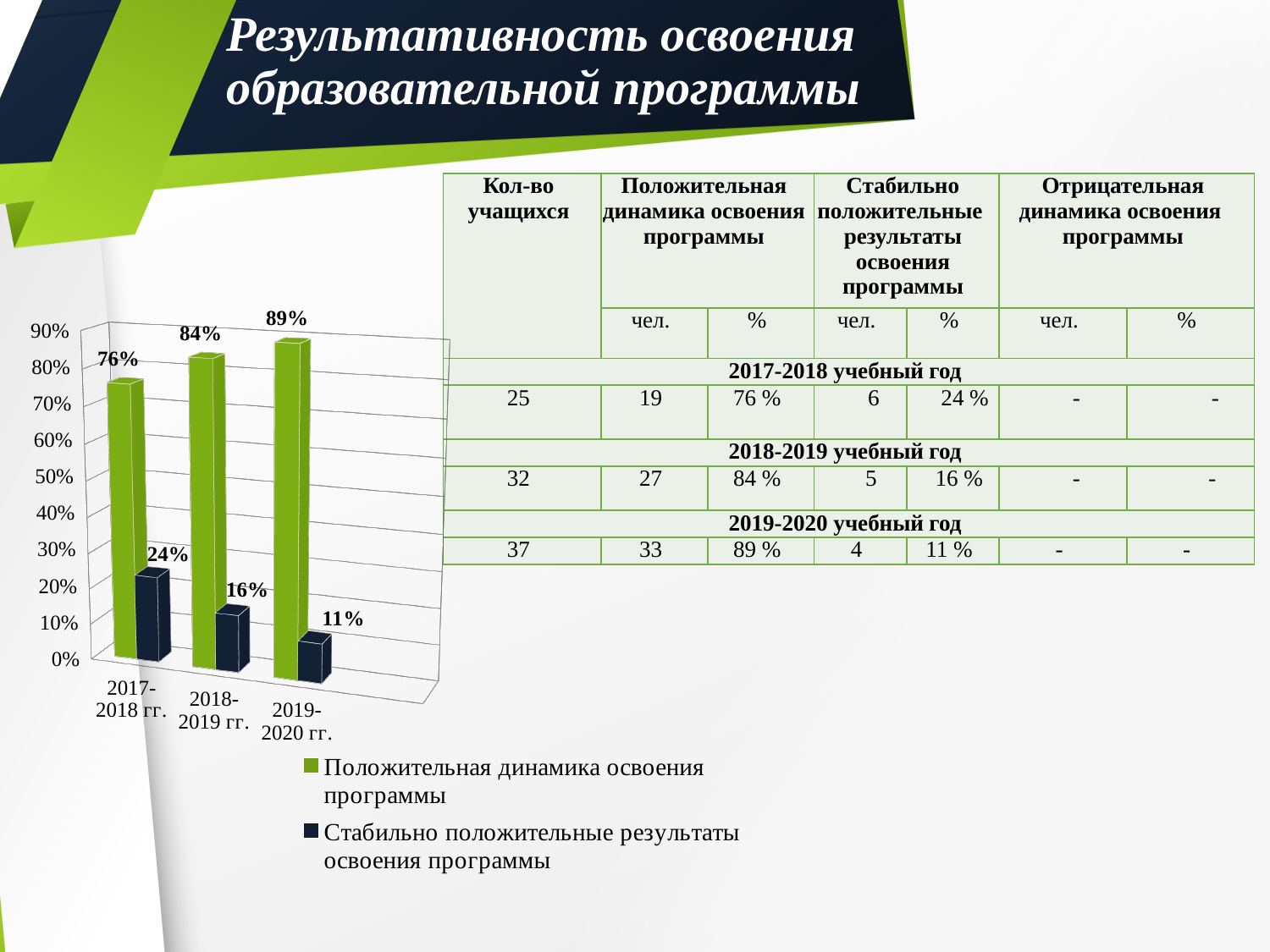
In which year is "Стабильно положительные результаты освоения программы" lowest? 2019-2020 гг. Which is larger: "Стабильно положительные результаты освоения программы" in 2017-2018 гг. or in 2018-2019 гг.? 2017-2018 гг. What kind of chart is shown on the slide? bar chart Does "Стабильно положительные результаты освоения программы" rise or fall from 2017-2018 гг. to 2019-2020 гг.? fall What is the value of "Положительная динамика освоения программы" for 2018-2019 гг.? 84% What is the value of "Положительная динамика освоения программы" for 2017-2018 гг.? 76% In which year is "Положительная динамика освоения программы" highest? 2019-2020 гг. What is the difference between "Положительная динамика освоения программы" and "Стабильно положительные результаты освоения программы" in 2017-2018 гг.? 52% How many series does the chart legend list? 2 What is the value of "Стабильно положительные результаты освоения программы" for 2019-2020 гг.? 11% How many year categories are shown on the x axis of the chart? 3 Is the value of "Положительная динамика освоения программы" for 2019-2020 гг. greater or less than 80%? greater